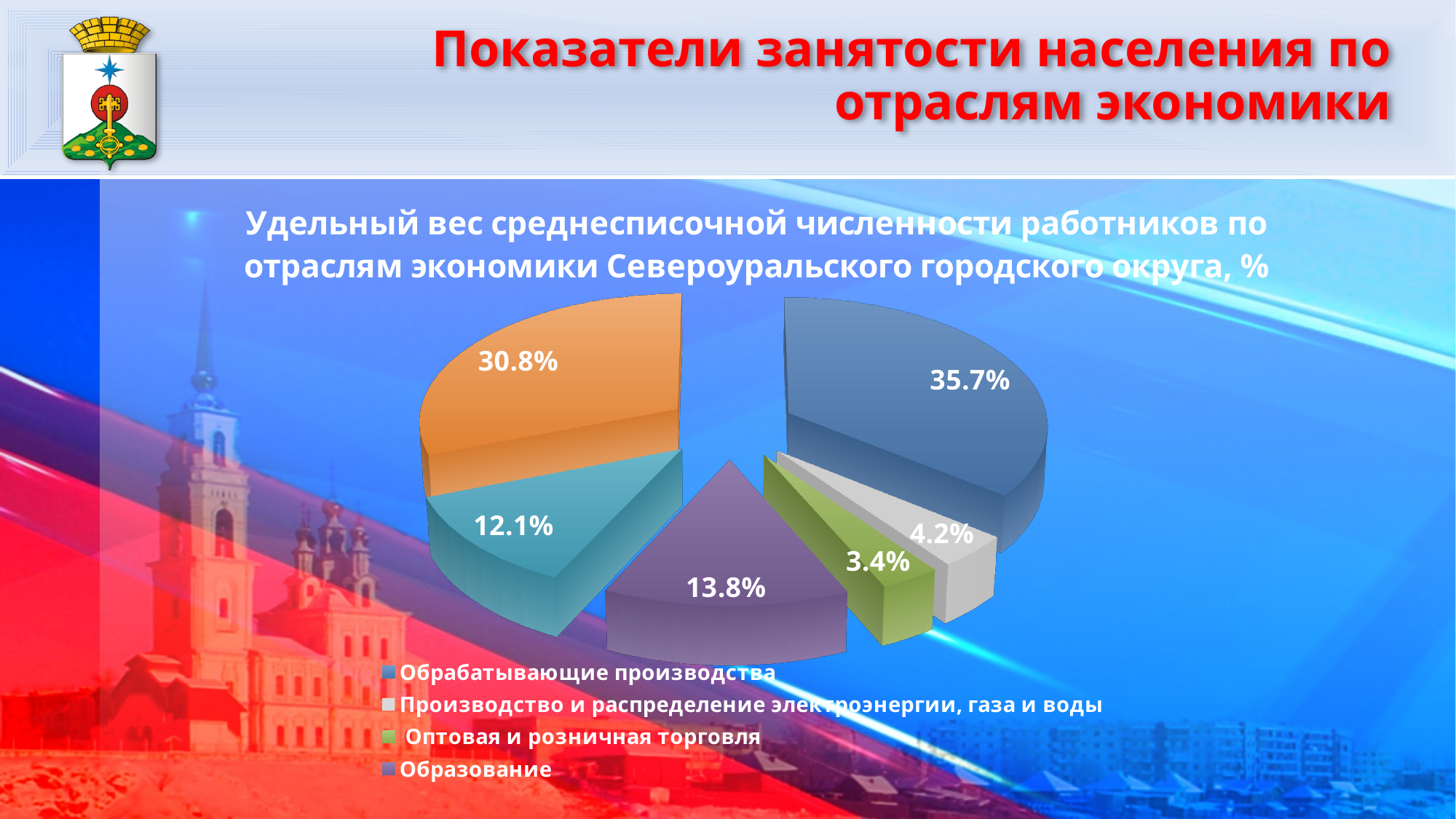
What value is shown on the orange slice of the pie? 30.8% Which category has the smallest slice of the pie? Оптовая и розничная торговля What value is shown on the teal slice of the pie? 12.1% What share of workers is in Производство и распределение электроэнергии, газа и воды? 4.2% What share of workers is in Оптовая и розничная торговля? 3.4% How many slices does the pie chart have? 6 What share of workers is in Образование? 13.8% Which category has the largest slice of the pie? Обрабатывающие производства What is the difference between the shares for Обрабатывающие производства and Образование? 21.9% Which is larger: the share for Образование or the share for Производство и распределение электроэнергии, газа и воды? Образование What share of workers is in Обрабатывающие производства? 35.7% What type of chart is shown on the slide? pie chart